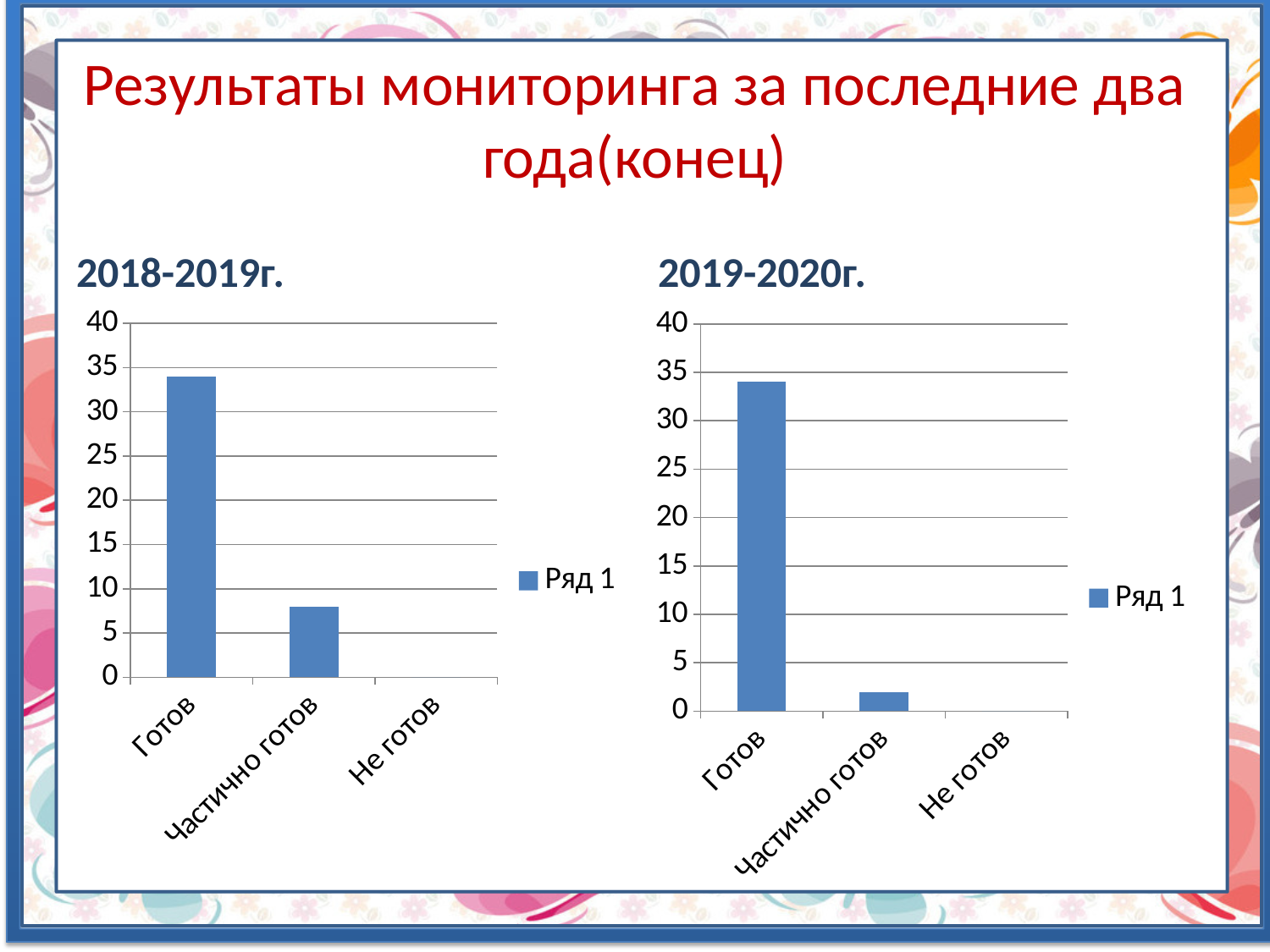
In the 2018-2019г. chart, is the value for Частично готов greater or less than 10? less How many series does the legend of the 2018-2019г. chart list? 1 In the 2018-2019г. chart, do the values rise or fall from left to right along the x axis? fall What is the name of the series shown in the legend of the 2019-2020г. chart? Ряд 1 What kind of chart is the 2018-2019г. chart on the left? bar chart How many categories are shown on the x axis of the 2019-2020г. chart? 3 In the 2019-2020г. chart, is the value for Готов greater or less than 30? greater In the 2018-2019г. chart, which category has the highest value? Готов In the 2019-2020г. chart, is the value for Частично готов greater or less than 5? less In the 2019-2020г. chart, which category has the lowest value? Не готов In the 2019-2020г. chart, which is larger: Готов or Частично готов? Готов